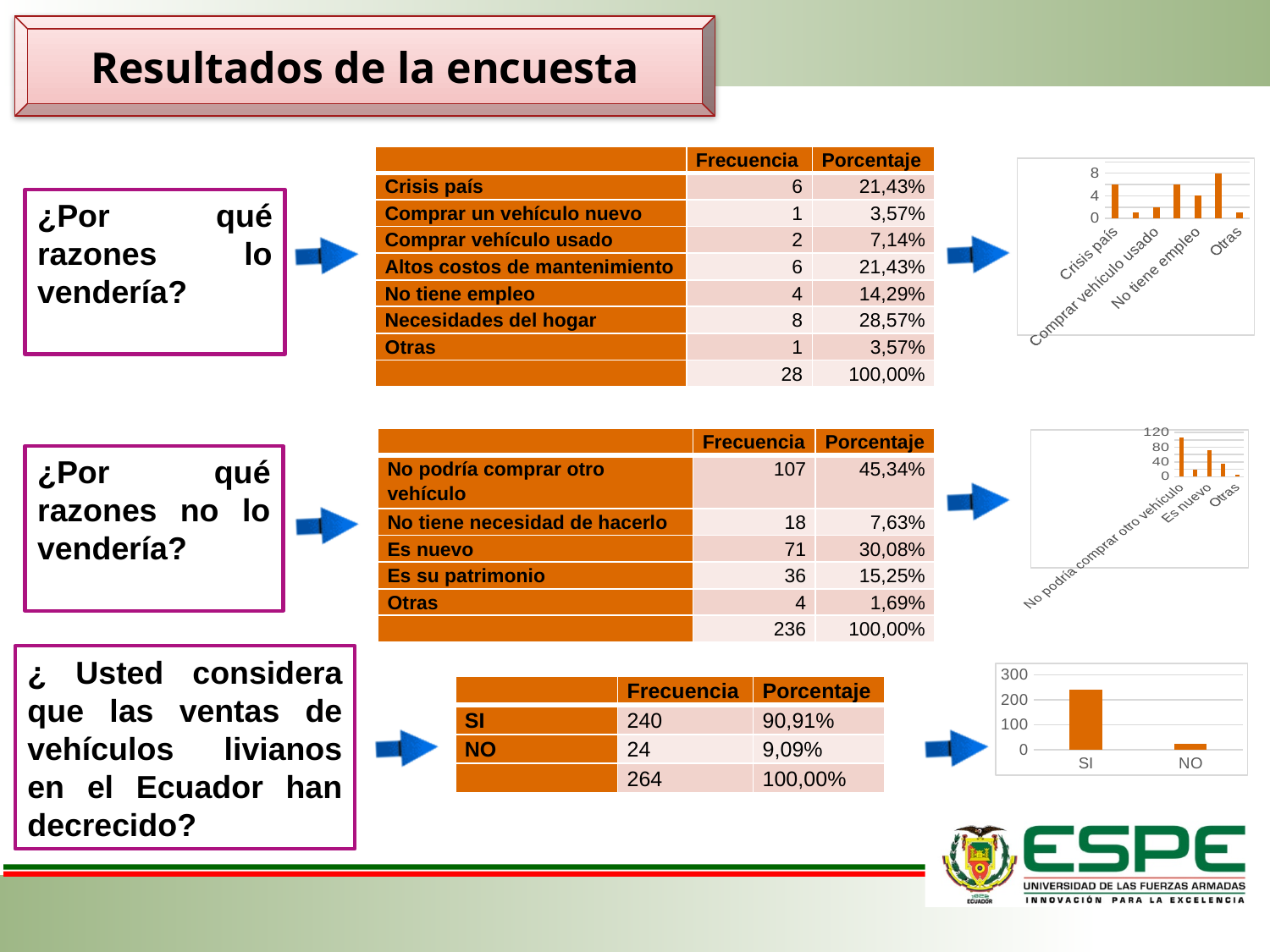
In the top-right chart (reasons for selling), which is larger, the value for Crisis país or the value for Otras? Crisis país In the top-right chart (reasons for selling), how many bars are plotted? 7 In the middle-right chart (reasons for not selling), which category has the highest bar? No podría comprar otro vehículo How many bars does the bottom-right chart (SI / NO) show? 2 In the top-right chart (reasons for selling), is the value for Crisis país greater or less than 4? greater In the middle-right chart (reasons for not selling), how many bars are plotted? 5 What kind of chart is the bottom-right chart with the categories SI and NO? bar chart In the middle-right chart (reasons for not selling), is the value for Es nuevo greater or less than 40? greater In the bottom-right chart (SI / NO), which category has the taller bar? SI In the bottom-right chart (SI / NO), is the value for SI greater or less than 200? greater